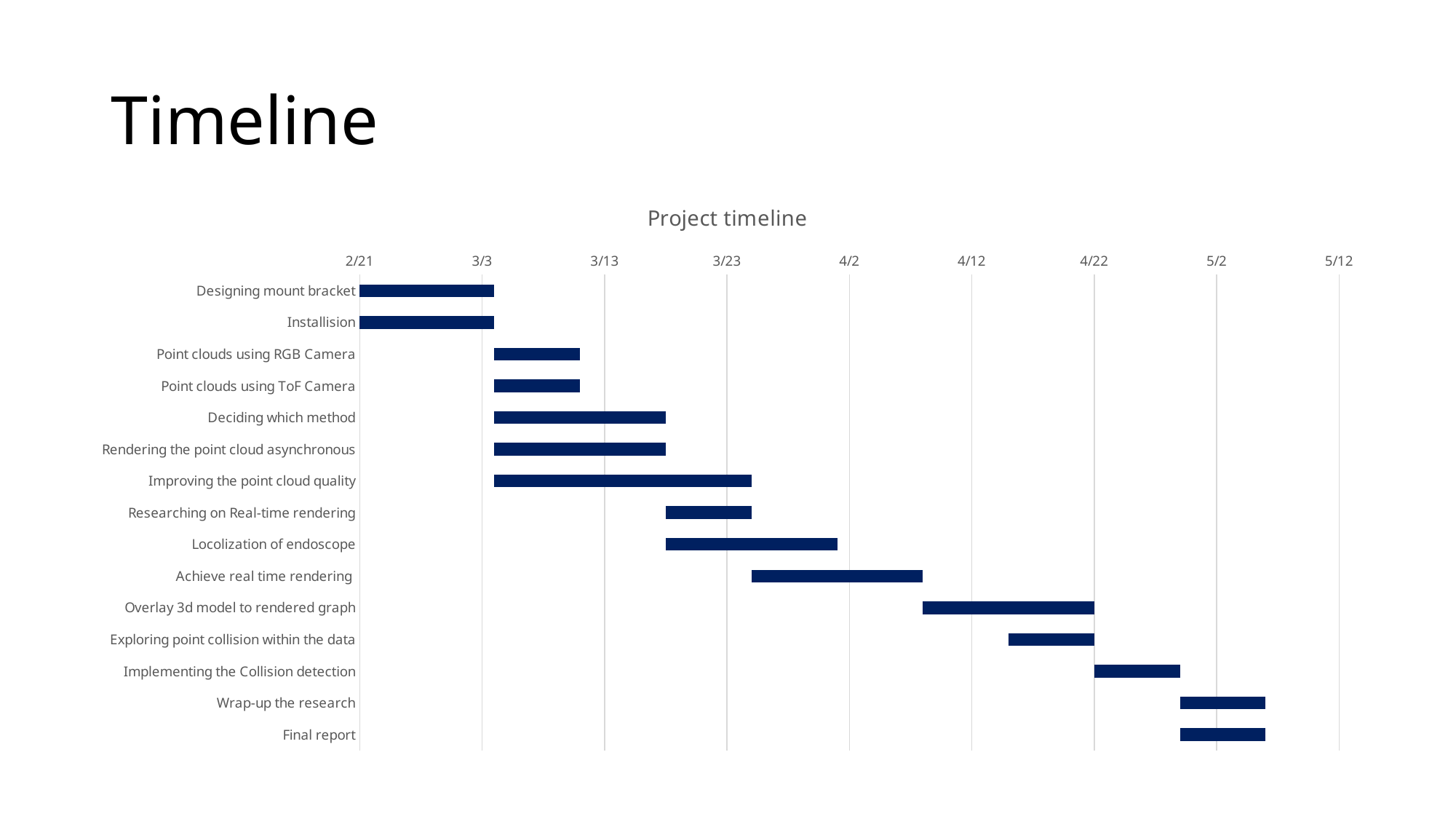
Which task has the longest bar on the chart? Improving the point cloud quality Which bar is longer, Improving the point cloud quality or Point clouds using RGB Camera? Improving the point cloud quality On what date does the bar for Designing mount bracket start? 2/21 On what date does the bar for Implementing the Collision detection start? 4/22 What is the last date label shown on the horizontal axis? 5/12 Which task starts later, Final report or Designing mount bracket? Final report Does the bar for Final report start before or after 4/22? after What is the title of the chart? Project timeline How many tasks are listed on the chart? 15 On what date does the bar for Overlay 3d model to rendered graph end? 4/22 What kind of chart is shown on the slide? bar chart Does the bar for Locolization of endoscope end before or after 4/2? before